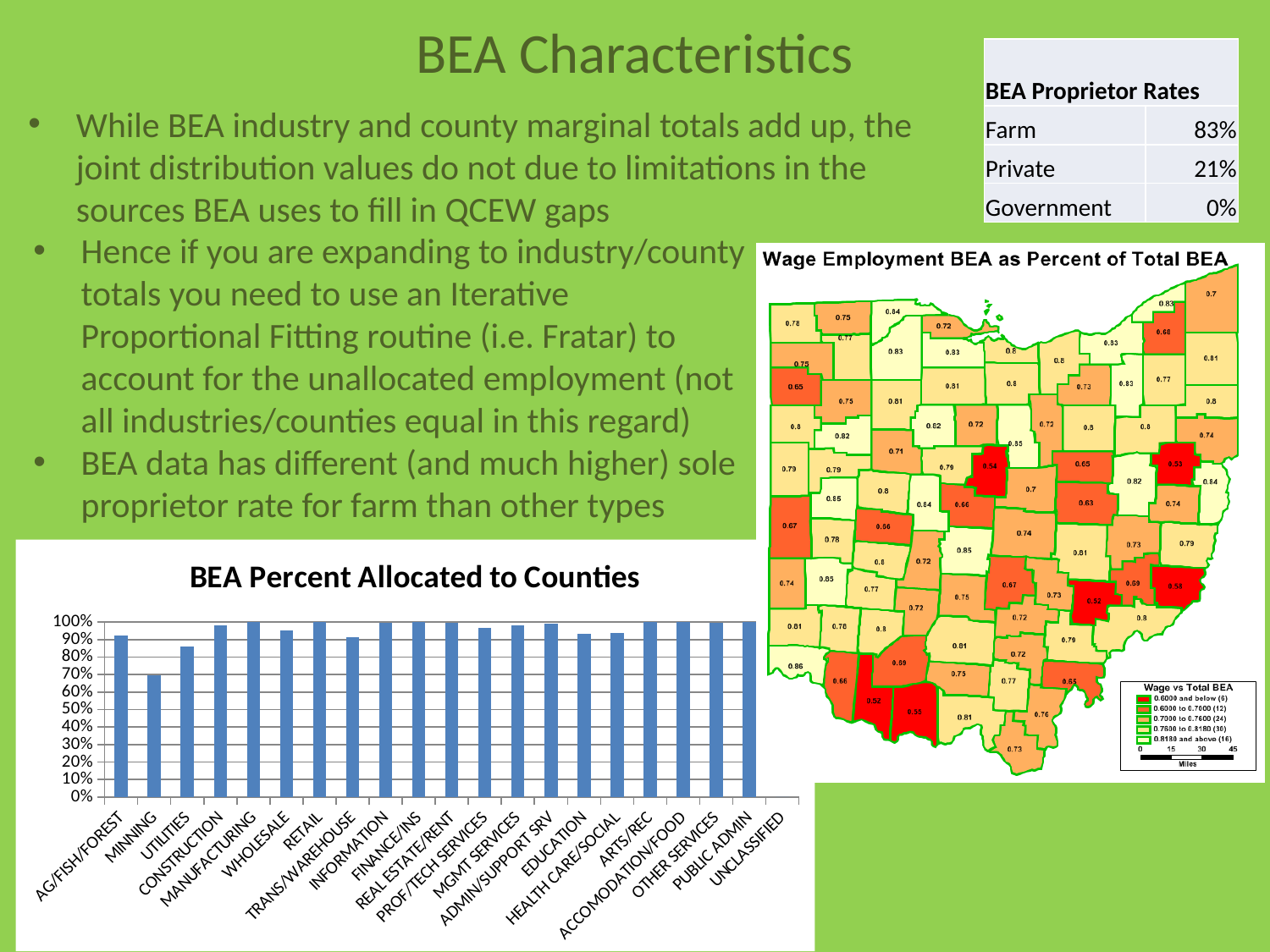
In the 'BEA Percent Allocated to Counties' chart, which is larger, the value for MINNING or the value for UTILITIES? UTILITIES In the 'BEA Percent Allocated to Counties' chart, which is larger, the value for MINNING or the value for AG/FISH/FOREST? AG/FISH/FOREST In the 'BEA Percent Allocated to Counties' chart, is the value for MINNING greater or less than 80%? less In the 'BEA Percent Allocated to Counties' chart, is the value for AG/FISH/FOREST greater or less than 80%? greater In the 'BEA Percent Allocated to Counties' chart, is the value for WHOLESALE greater or less than 90%? greater How many industry categories are shown in the 'BEA Percent Allocated to Counties' chart? 21 In the 'BEA Percent Allocated to Counties' chart, which is larger, the value for UTILITIES or the value for CONSTRUCTION? CONSTRUCTION What is the title of the bar chart at the bottom left of the slide? BEA Percent Allocated to Counties What kind of chart is 'BEA Percent Allocated to Counties'? bar chart In the 'BEA Percent Allocated to Counties' chart, which industry has the lowest percent allocated? UNCLASSIFIED